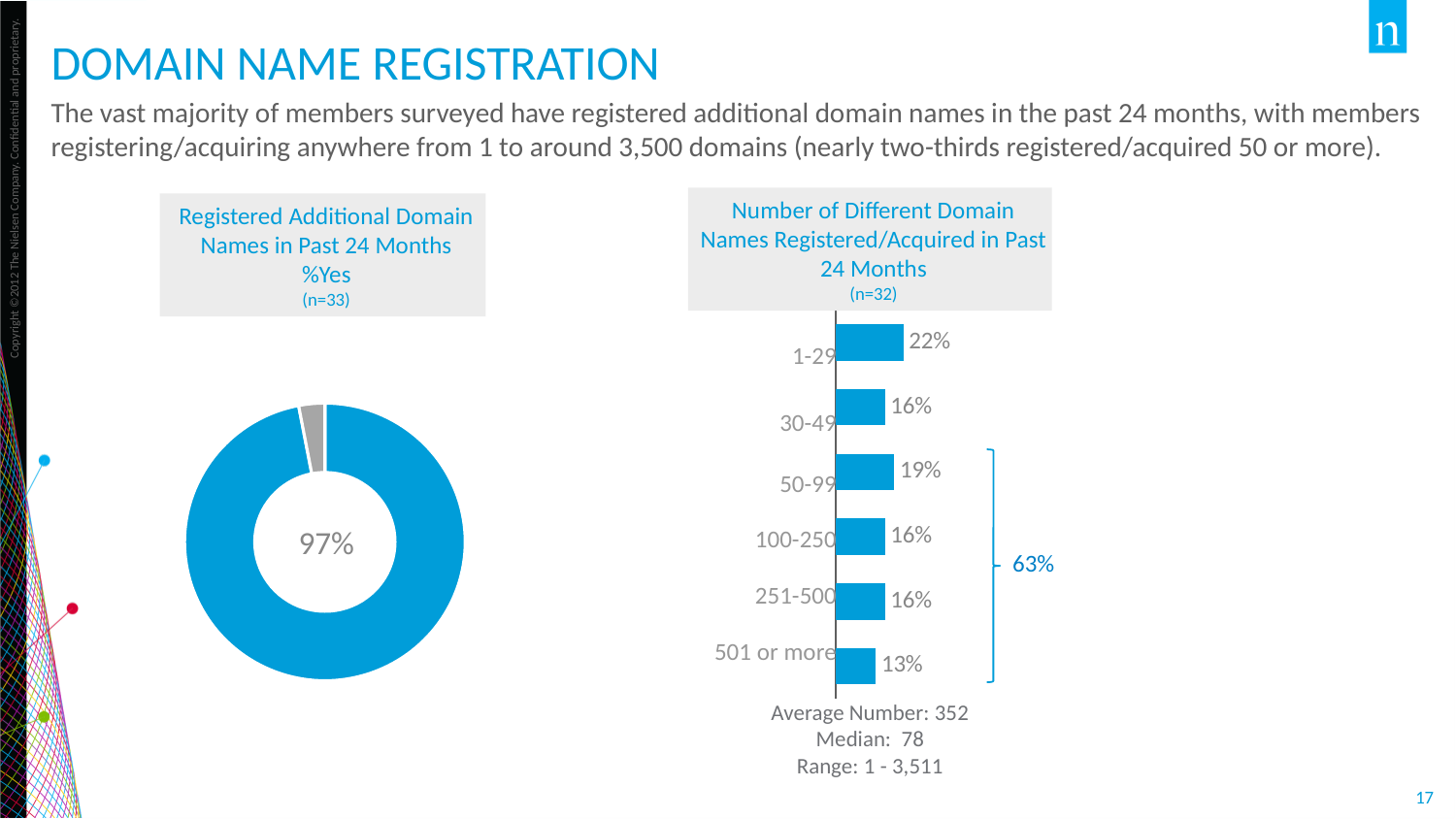
In the 'Number of Different Domain Names Registered/Acquired in Past 24 Months' chart, what is the difference between the values for 1-29 and 501 or more? 9% In the 'Number of Different Domain Names Registered/Acquired in Past 24 Months' chart, what is the value for the 1-29 category? 22% What kind of chart is the 'Number of Different Domain Names Registered/Acquired in Past 24 Months' chart? Bar chart In the 'Number of Different Domain Names Registered/Acquired in Past 24 Months' chart, what combined percentage does the bracket covering 50-99 through 501 or more show? 63% In the 'Number of Different Domain Names Registered/Acquired in Past 24 Months' chart, which category has the lowest value? 501 or more How many categories are shown in the 'Number of Different Domain Names Registered/Acquired in Past 24 Months' chart? 6 In the 'Number of Different Domain Names Registered/Acquired in Past 24 Months' chart, what is the value for the 501 or more category? 13% What kind of chart is the 'Registered Additional Domain Names in Past 24 Months' chart on the left? Donut chart In the 'Number of Different Domain Names Registered/Acquired in Past 24 Months' chart, which category has the highest value? 1-29 In the 'Number of Different Domain Names Registered/Acquired in Past 24 Months' chart, what is the value for the 50-99 category? 19% In the 'Number of Different Domain Names Registered/Acquired in Past 24 Months' chart, which is larger, the value for 50-99 or the value for 100-250? 50-99 In the 'Registered Additional Domain Names in Past 24 Months' chart, what percentage of members answered Yes? 97%